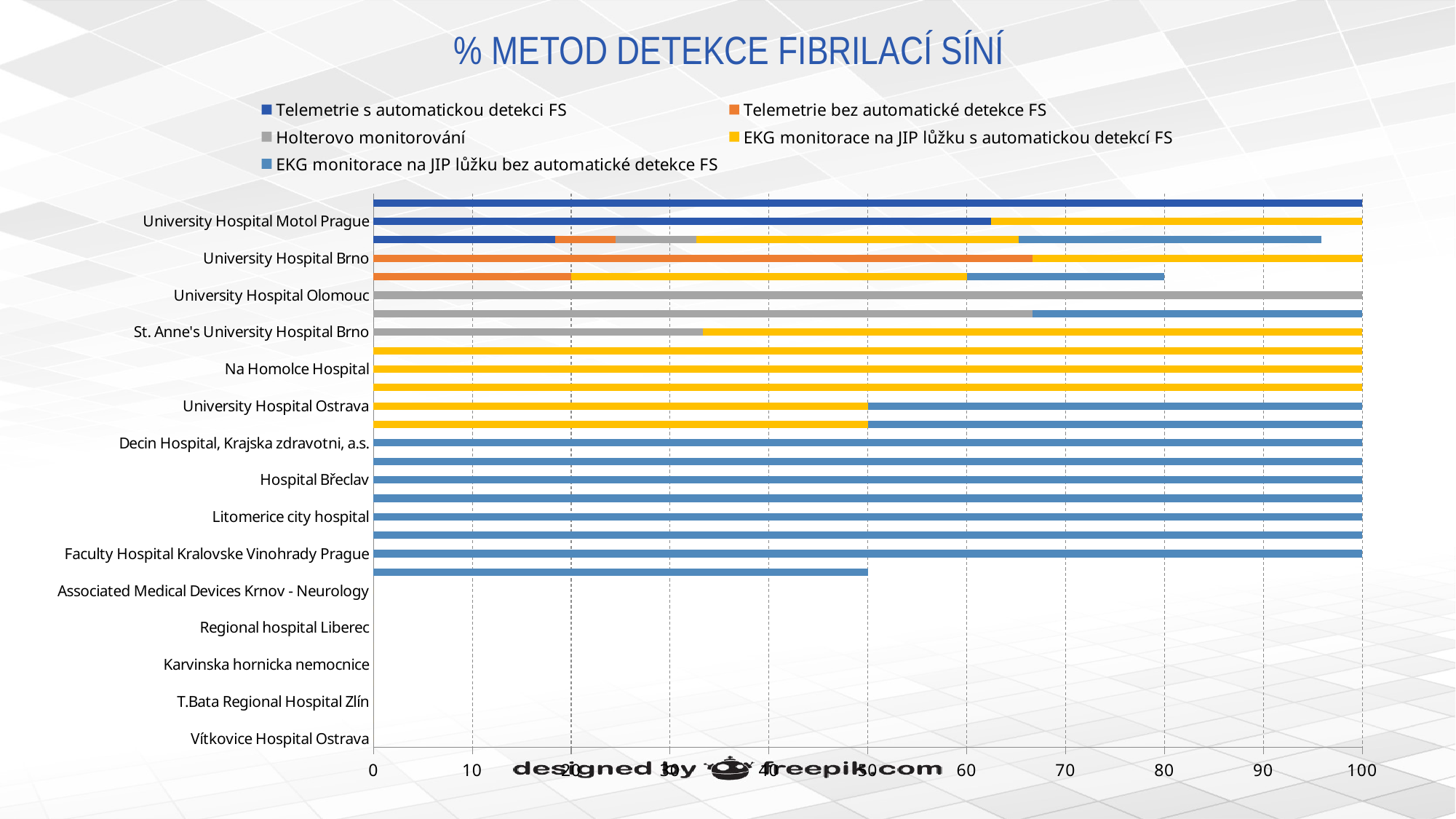
Which series is shown in grey in the legend? Holterovo monitorování Is the Holterovo monitorování value for St. Anne's University Hospital Brno greater or less than 40? less What kind of chart is shown on the slide? bar chart What is the title of the chart? % METOD DETEKCE FIBRILACÍ SÍNÍ Is the EKG monitorace na JIP lůžku bez automatické detekce FS value for Hospital Břeclav greater or less than 90? greater Is the EKG monitorace na JIP lůžku s automatickou detekcí FS value for Na Homolce Hospital greater or less than 90? greater Which is larger for University Hospital Motol Prague: the Telemetrie s automatickou detekci FS value or the EKG monitorace na JIP lůžku s automatickou detekcí FS value? Telemetrie s automatickou detekci FS How many series does the legend list? 5